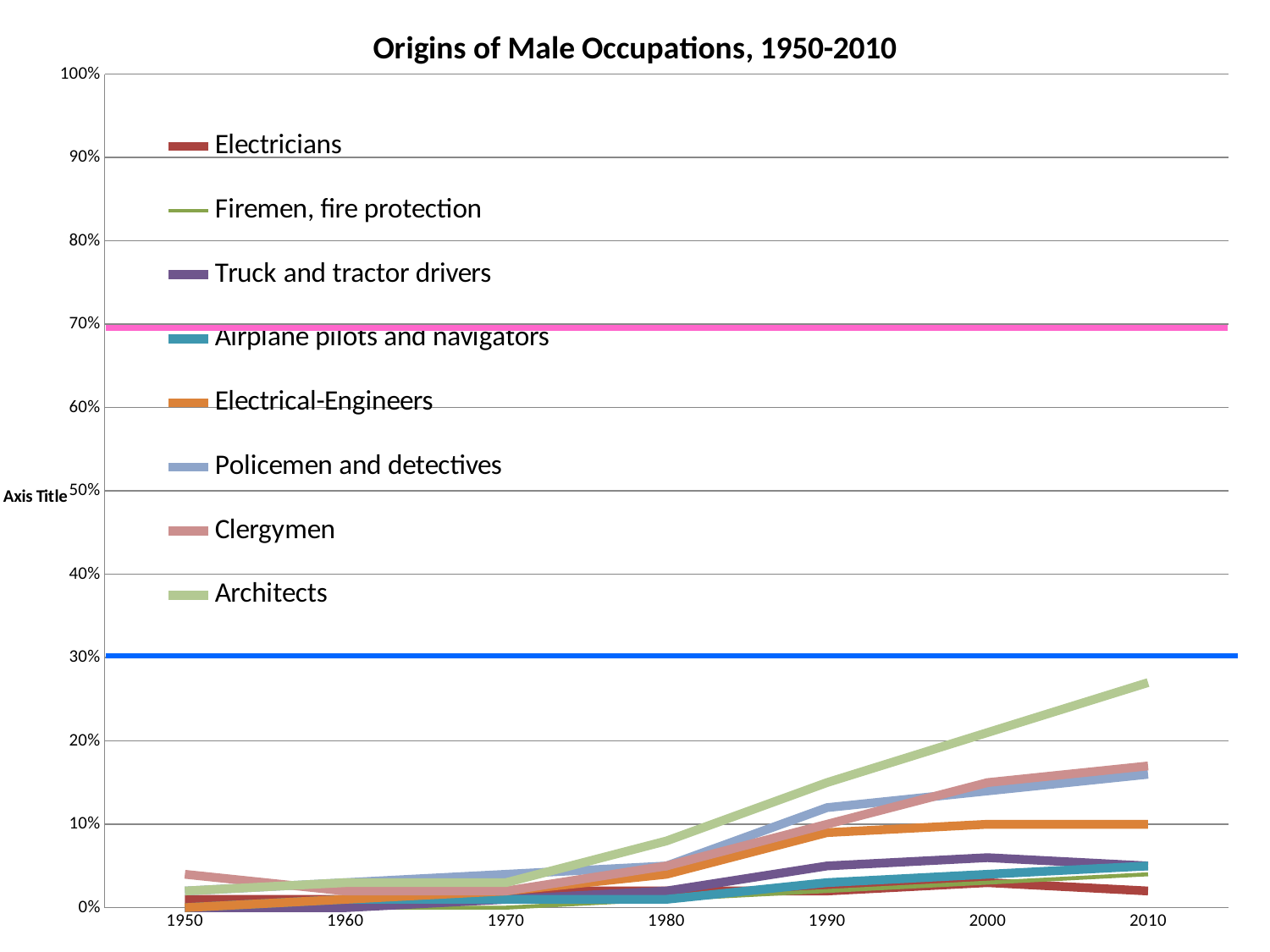
Is the value for Architects in 2010 greater or less than 30%? less In 2010, which is larger: the value for Architects or the value for Electrical-Engineers? Architects Which occupation has the highest value in 2010? Architects How many years are marked along the x axis? 7 Which occupation has the lowest value in 2010? Electricians Is the value for Clergymen in 2010 greater or less than 10%? greater What is the title of the chart? Origins of Male Occupations, 1950-2010 Is the value for Architects in 2010 greater or less than 20%? greater Does the value for Architects rise or fall from 1950 to 2010? rise How many series does the legend list? 8 What kind of chart is shown on the slide? line chart